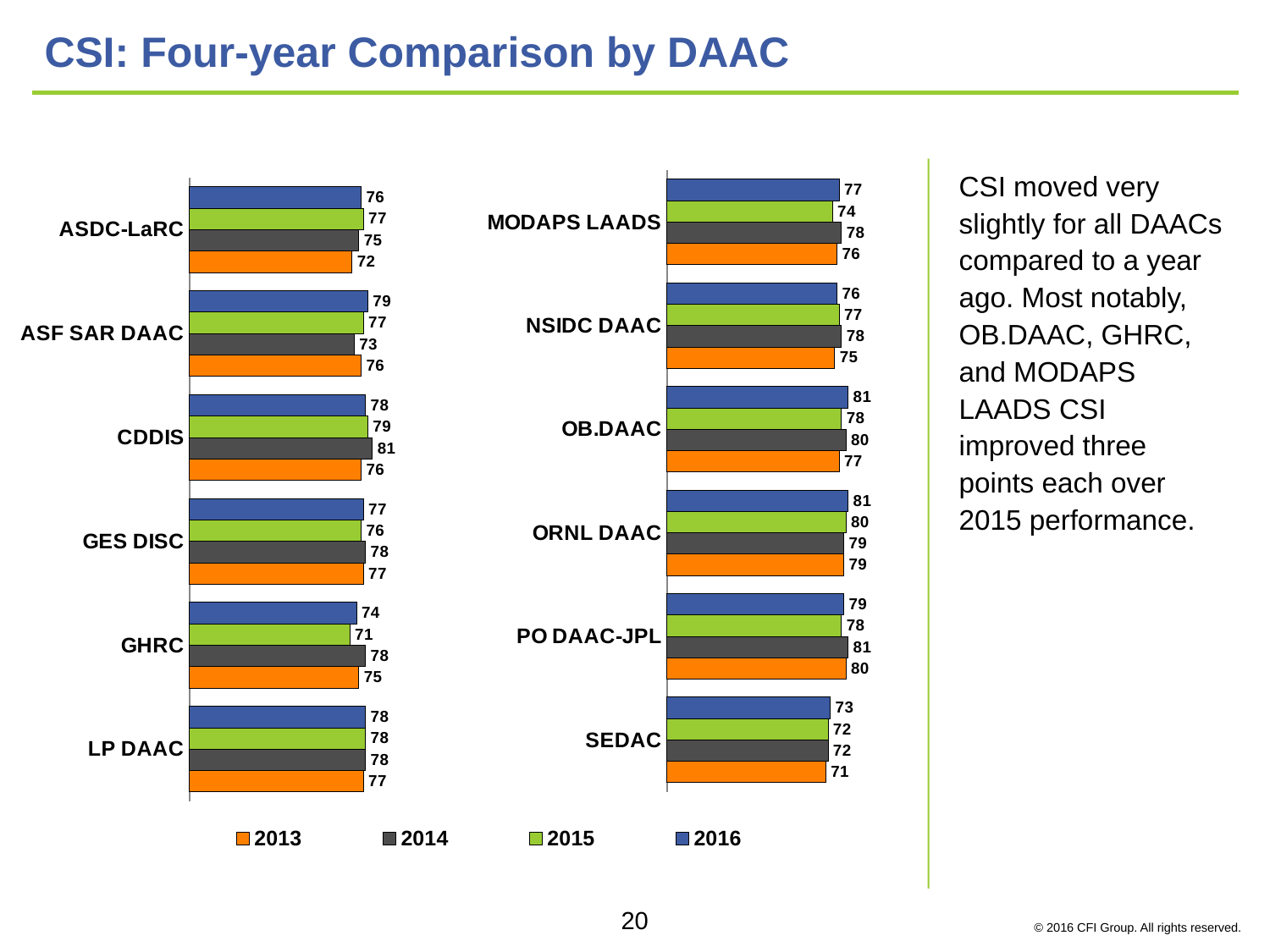
In the left chart, what is the 2015 value for GHRC? 71 In the right chart, which DAAC has the lowest 2016 value? SEDAC In the right chart, what is the difference between the 2016 and 2015 values for OB.DAAC? 3 In the left chart, what is the 2016 value for ASF SAR DAAC? 79 How many DAACs are shown in the right chart? 6 In the left chart, which is larger for ASDC-LaRC: the 2013 value or the 2015 value? 2015 How many series does the legend list? 4 In the left chart, which DAAC has the highest 2014 value? CDDIS What kind of chart is the left chart? Bar chart In the left chart, what is the difference between the 2014 and 2015 values for GHRC? 7 In the right chart, which is larger for PO DAAC-JPL: the 2014 value or the 2016 value? 2014 In the right chart, what is the 2013 value for OB.DAAC? 77